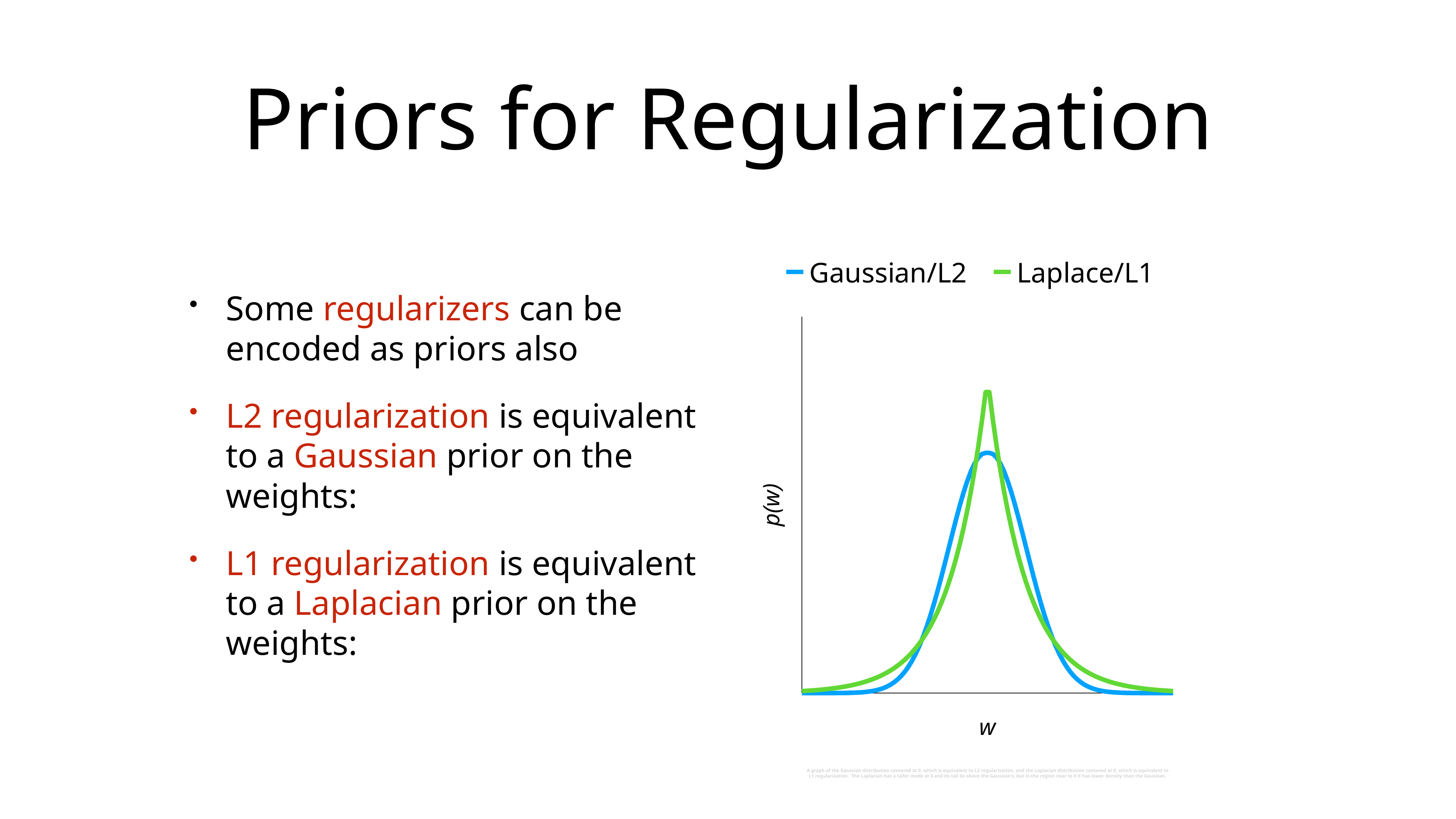
What colour is the Laplace/L1 line in the chart? green How many series does the chart's legend list? 2 Which series has the sharper, more pointed peak in the chart? Laplace/L1 Which series has the lower maximum value in the chart? Gaussian/L2 What kind of chart is shown on the slide? line chart What is the label on the chart's horizontal axis? w What is the label on the chart's vertical axis? p(w) Which series reaches the higher peak, Gaussian/L2 or Laplace/L1? Laplace/L1 Does the Gaussian/L2 line rise or fall as w moves from the centre of the chart toward the right edge? fall Does the Laplace/L1 line rise or fall as w moves from the left edge of the chart toward the centre? rise